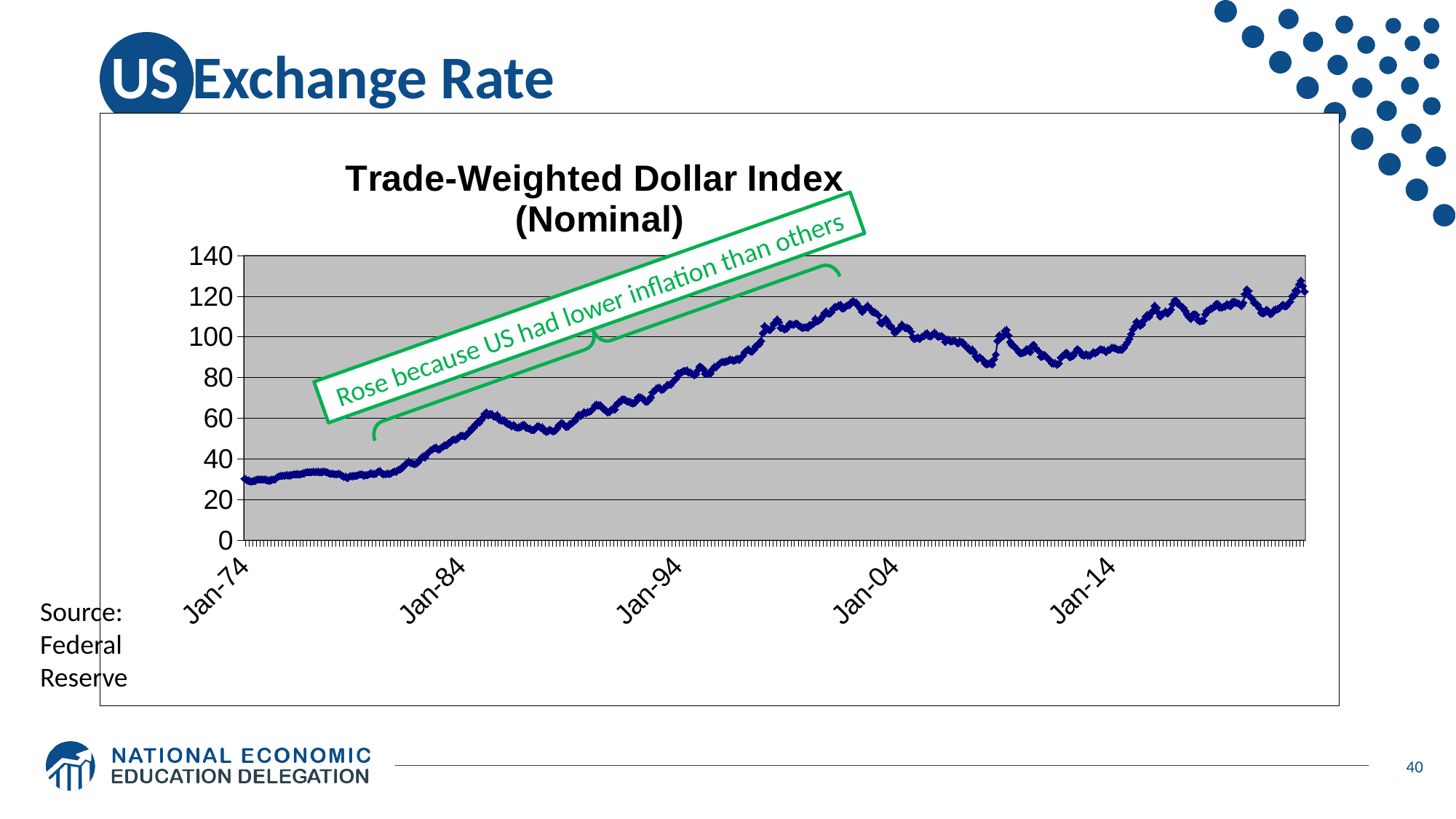
Is the value of the index at Jan-94 greater or less than 60? greater Which is larger, the index value at Jan-84 or at Jan-04? Jan-04 How many date labels are shown on the x axis? 5 Is the value of the index at Jan-74 greater or less than 40? less What is the highest value shown on the y axis? 140 What is the title of the chart? Trade-Weighted Dollar Index (Nominal) Is the value of the index at Jan-84 greater or less than 40? greater Overall, does the Trade-Weighted Dollar Index rise or fall from Jan-74 to the end of the series? Rise What kind of chart is shown on the slide? Line chart Which is larger, the index value at Jan-74 or at Jan-14? Jan-14